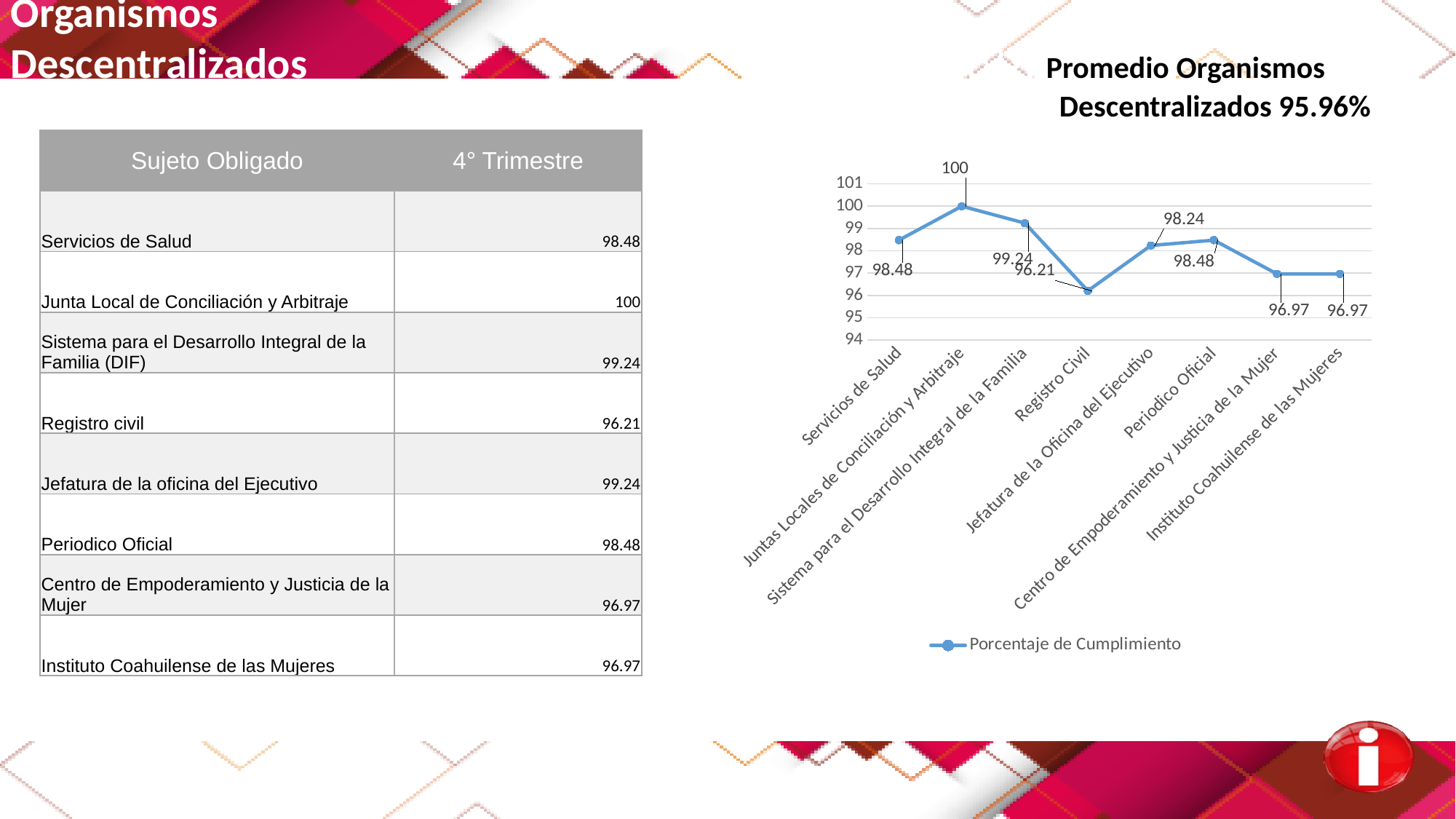
Which is larger in the line chart: the value for Sistema para el Desarrollo Integral de la Familia or the value for Periodico Oficial? Sistema para el Desarrollo Integral de la Familia Which category has the highest value in the line chart? Juntas Locales de Conciliación y Arbitraje Is the value for Centro de Empoderamiento y Justicia de la Mujer greater or less than 98? less How many series does the chart legend list? 1 Which category has the lowest value in the line chart? Registro Civil What is the value for Servicios de Salud in the line chart? 98.48 What type of chart is shown on the slide? Line chart How many categories are plotted on the x axis of the line chart? 8 What is the value for Instituto Coahuilense de las Mujeres in the line chart? 96.97 What is the name of the series shown in the chart legend? Porcentaje de Cumplimiento What is the difference between the values for Juntas Locales de Conciliación y Arbitraje and Registro Civil? 3.79 What is the value for Registro Civil in the line chart? 96.21